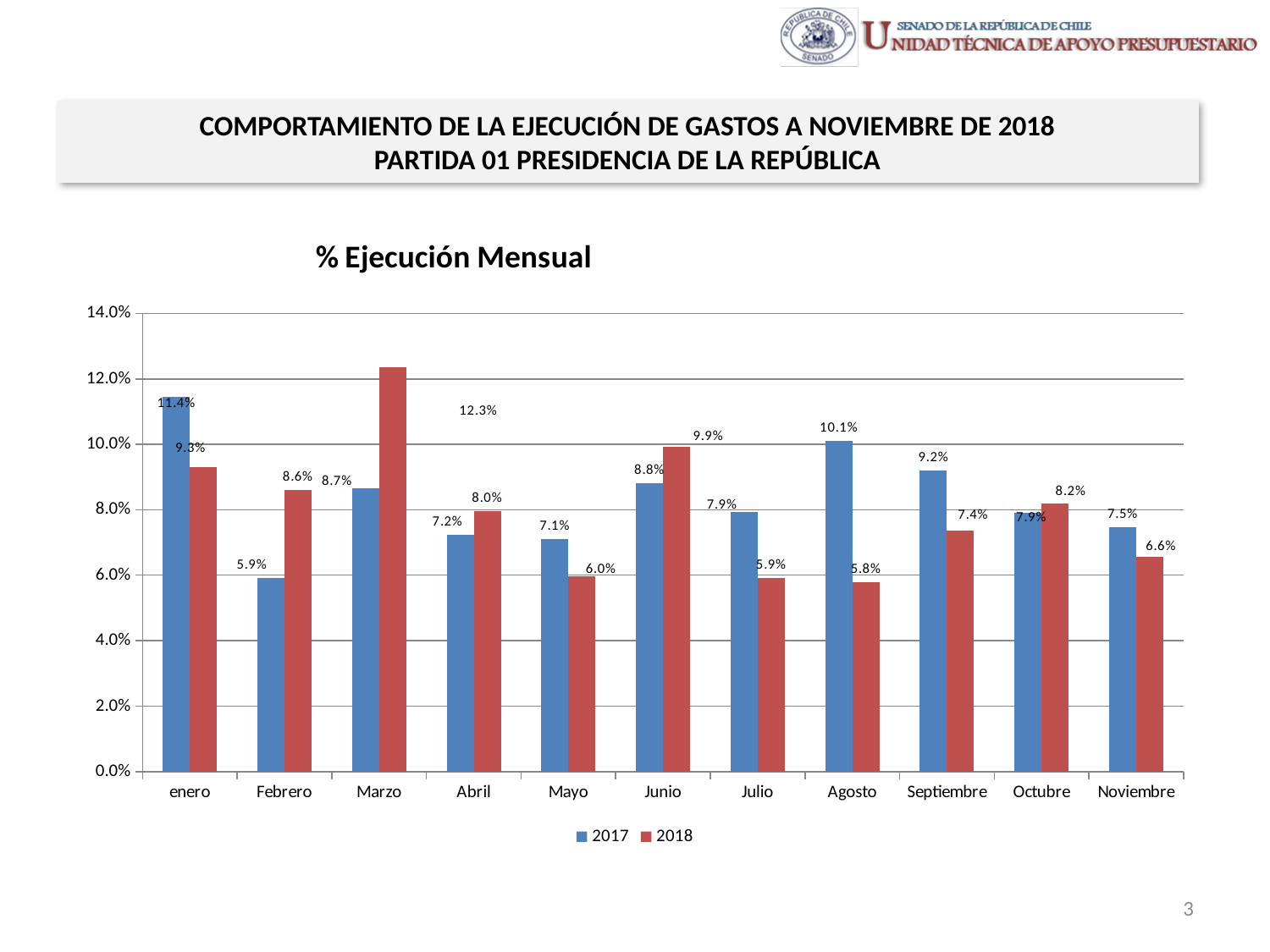
Which month has the highest 2017 value? enero What is the 2018 value for Marzo? 12.3% What is the 2018 value for Noviembre? 6.6% Is the 2017 value for Febrero greater or less than 6.0%? less What is the 2017 value for Agosto? 10.1% What is the title of the chart? % Ejecución Mensual Which is larger for Junio, the 2017 value or the 2018 value? 2018 What is the difference between the 2017 and 2018 values for enero? 2.1% What kind of chart is shown? bar chart Which month has the lowest 2018 value? Agosto How many months are shown on the x axis? 11 How many series does the legend list? 2